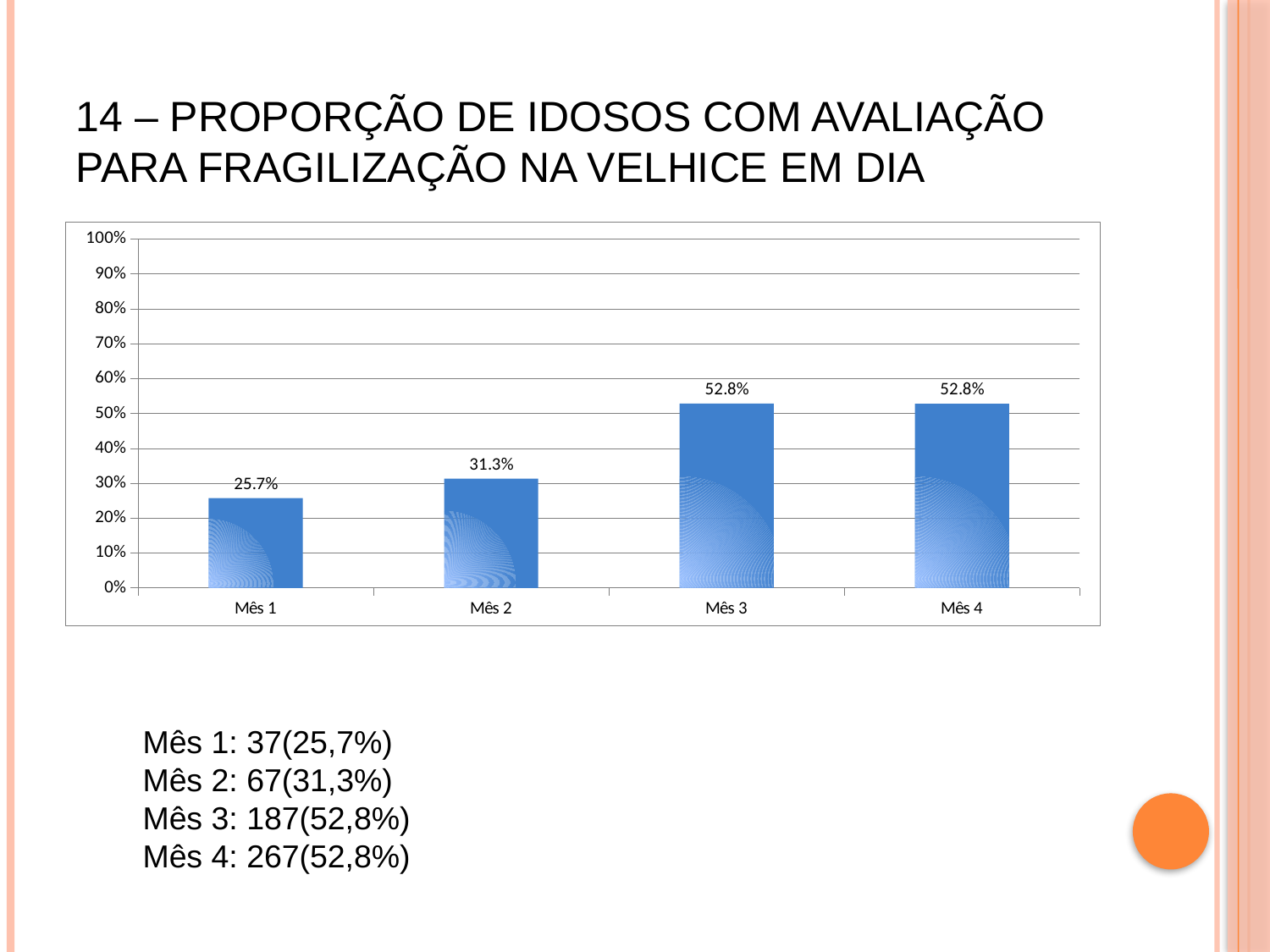
What is the value for Mês 3? 52.8% What is the value for Mês 2? 31.3% What is the value for Mês 4? 52.8% How many categories are shown on the x axis? 4 What is the difference between the values for Mês 3 and Mês 1? 27.1 percentage points What is the difference between the values for Mês 2 and Mês 1? 5.6 percentage points Which category has the lowest value? Mês 1 Is the value for Mês 3 greater or less than 50%? greater Do the values rise or fall from Mês 1 to Mês 3? rise Which is larger, the value for Mês 2 or the value for Mês 1? Mês 2 What kind of chart is shown on the slide? bar chart What is the value for Mês 1? 25.7%